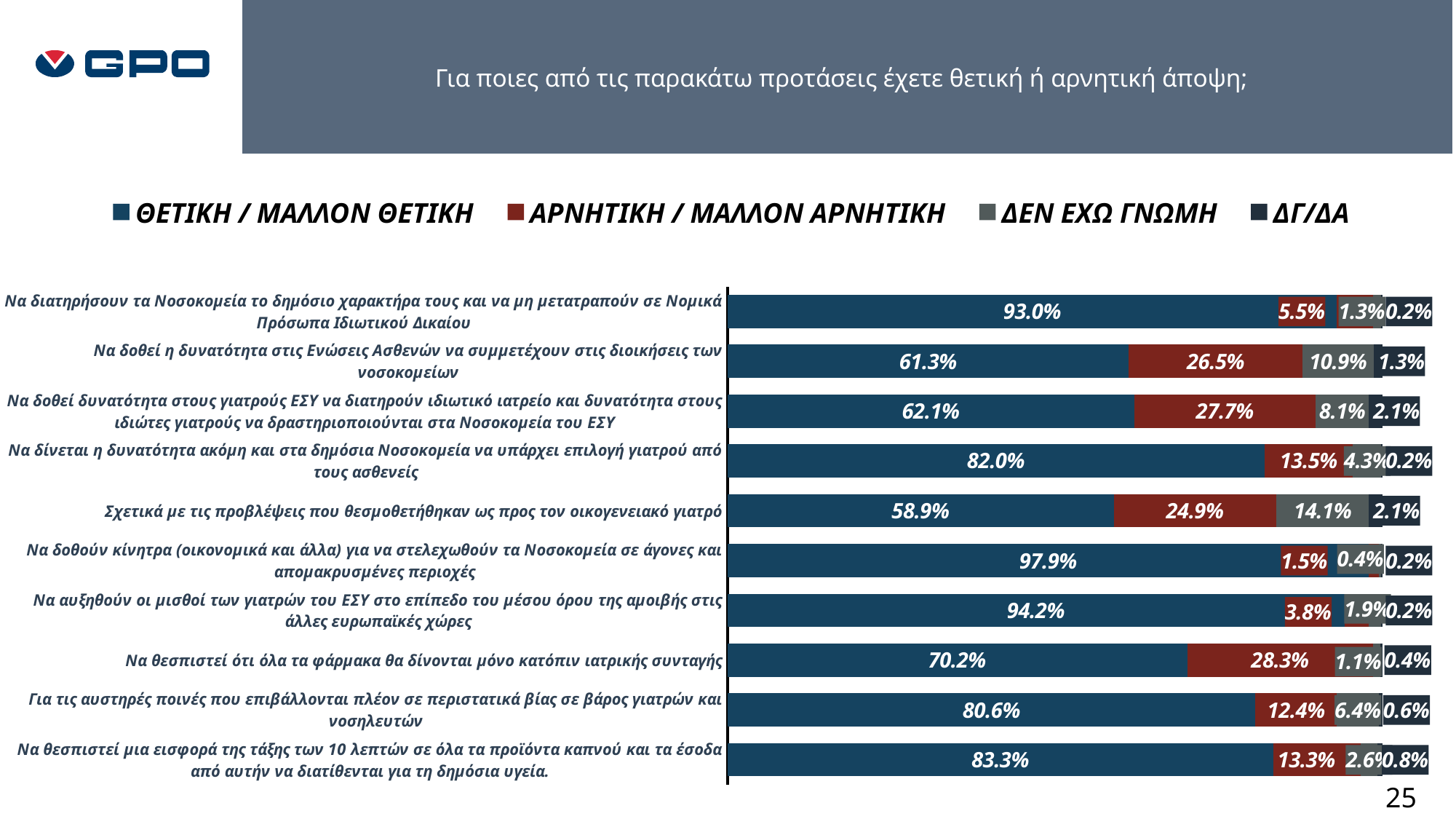
Which has a larger ΑΡΝΗΤΙΚΗ / ΜΑΛΛΟΝ ΑΡΝΗΤΙΚΗ value: the statement on ΕΣΥ doctors keeping private practices or the statement on patient associations in hospital administrations? The statement on ΕΣΥ doctors keeping private practices (27.7%) Which statement has the lowest ΘΕΤΙΚΗ / ΜΑΛΛΟΝ ΘΕΤΙΚΗ value? Σχετικά με τις προβλέψεις που θεσμοθετήθηκαν ως προς τον οικογενειακό γιατρό How many statements (categories) are plotted in the chart? 10 What is the ΔΕΝ ΕΧΩ ΓΝΩΜΗ value for the statement about the family doctor provisions (Σχετικά με τις προβλέψεις... οικογενειακό γιατρό)? 14.1% What is the ΑΡΝΗΤΙΚΗ / ΜΑΛΛΟΝ ΑΡΝΗΤΙΚΗ value for the statement that all medicines be given only by prescription (Να θεσπιστεί ότι όλα τα φάρμακα...)? 28.3% What is the difference between the ΘΕΤΙΚΗ / ΜΑΛΛΟΝ ΘΕΤΙΚΗ values for the statement on raising ΕΣΥ doctors' salaries (94.2%) and the statement on patient associations in hospital administrations (61.3%)? 32.9 percentage points What is the ΘΕΤΙΚΗ / ΜΑΛΛΟΝ ΘΕΤΙΚΗ value for the statement about incentives to staff hospitals in remote areas (Να δοθούν κίνητρα...)? 97.9% What kind of chart is shown on the slide? Stacked horizontal bar chart What colour represents the ΑΡΝΗΤΙΚΗ / ΜΑΛΛΟΝ ΑΡΝΗΤΙΚΗ series in the chart? Dark red How many series does the legend list? 4 What is the ΔΓ/ΔΑ value for the statement about strict penalties for violence against doctors and nurses (Για τις αυστηρές ποινές...)? 0.6% Which statement has the highest ΘΕΤΙΚΗ / ΜΑΛΛΟΝ ΘΕΤΙΚΗ value? Να δοθούν κίνητρα (οικονομικά και άλλα) για να στελεχωθούν τα Νοσοκομεία σε άγονες και απομακρυσμένες περιοχές